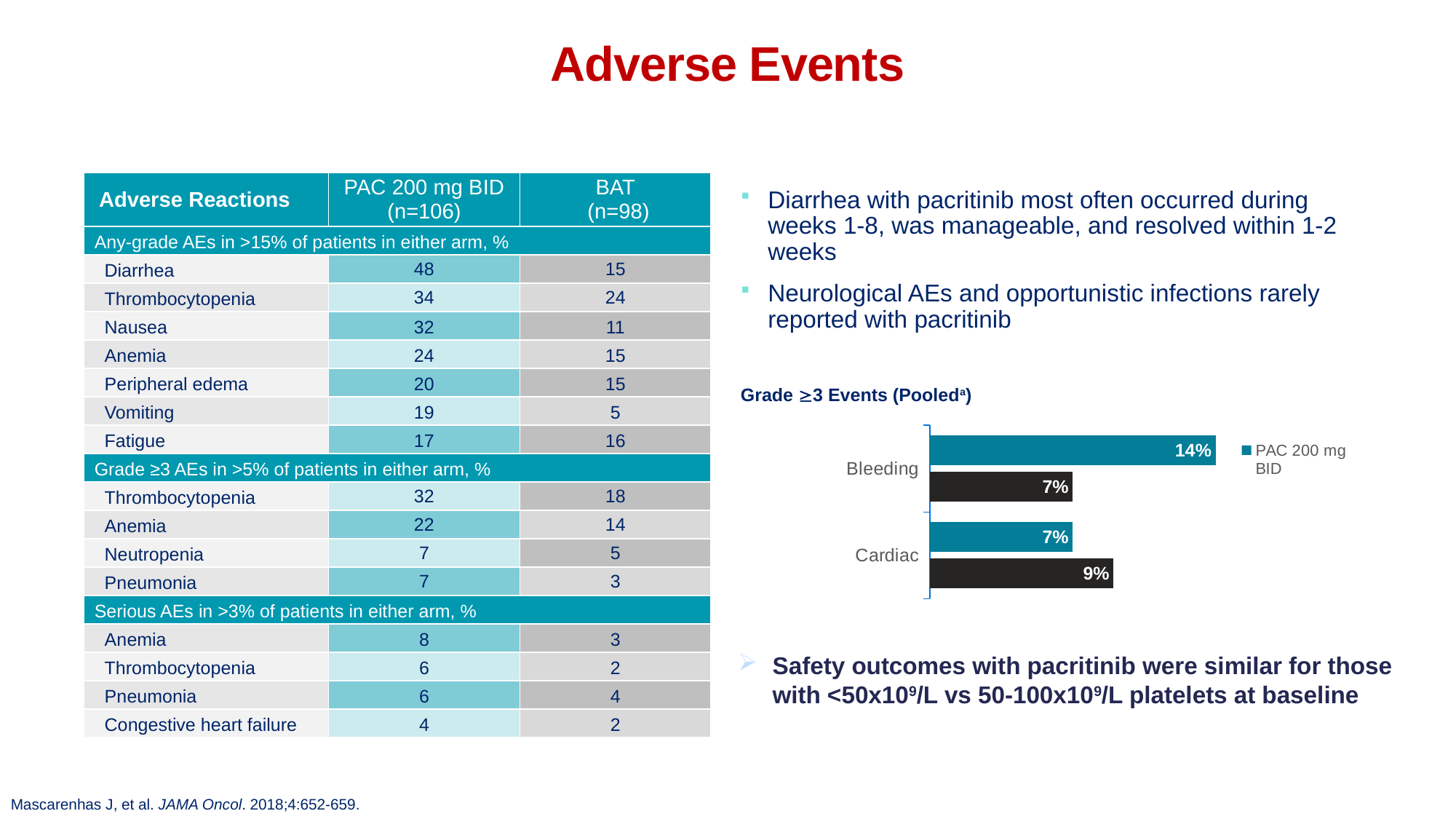
In the Grade ≥3 Events (Pooled) chart, what is the difference between the black bar and the PAC 200 mg BID bar for Cardiac? 2% In the Grade ≥3 Events (Pooled) chart, which category has the higher PAC 200 mg BID value? Bleeding In the Grade ≥3 Events (Pooled) chart, what is the difference between the PAC 200 mg BID bar and the black bar for Bleeding? 7% What series name is listed in the legend of the Grade ≥3 Events (Pooled) chart? PAC 200 mg BID In the Grade ≥3 Events (Pooled) chart, what is the value for PAC 200 mg BID for Bleeding? 14% In the Grade ≥3 Events (Pooled) chart, for Cardiac, is the PAC 200 mg BID bar or the black bar larger? The black bar In the Grade ≥3 Events (Pooled) chart, what is the value for PAC 200 mg BID for Cardiac? 7% How many categories are shown in the Grade ≥3 Events (Pooled) chart? 2 In the Grade ≥3 Events (Pooled) chart, is the PAC 200 mg BID value for Bleeding larger or smaller than the PAC 200 mg BID value for Cardiac? Larger In the Grade ≥3 Events (Pooled) chart, what value is shown on the black bar for Cardiac? 9% In the Grade ≥3 Events (Pooled) chart, what value is shown on the black bar for Bleeding? 7% What kind of chart is the Grade ≥3 Events (Pooled) chart? Bar chart